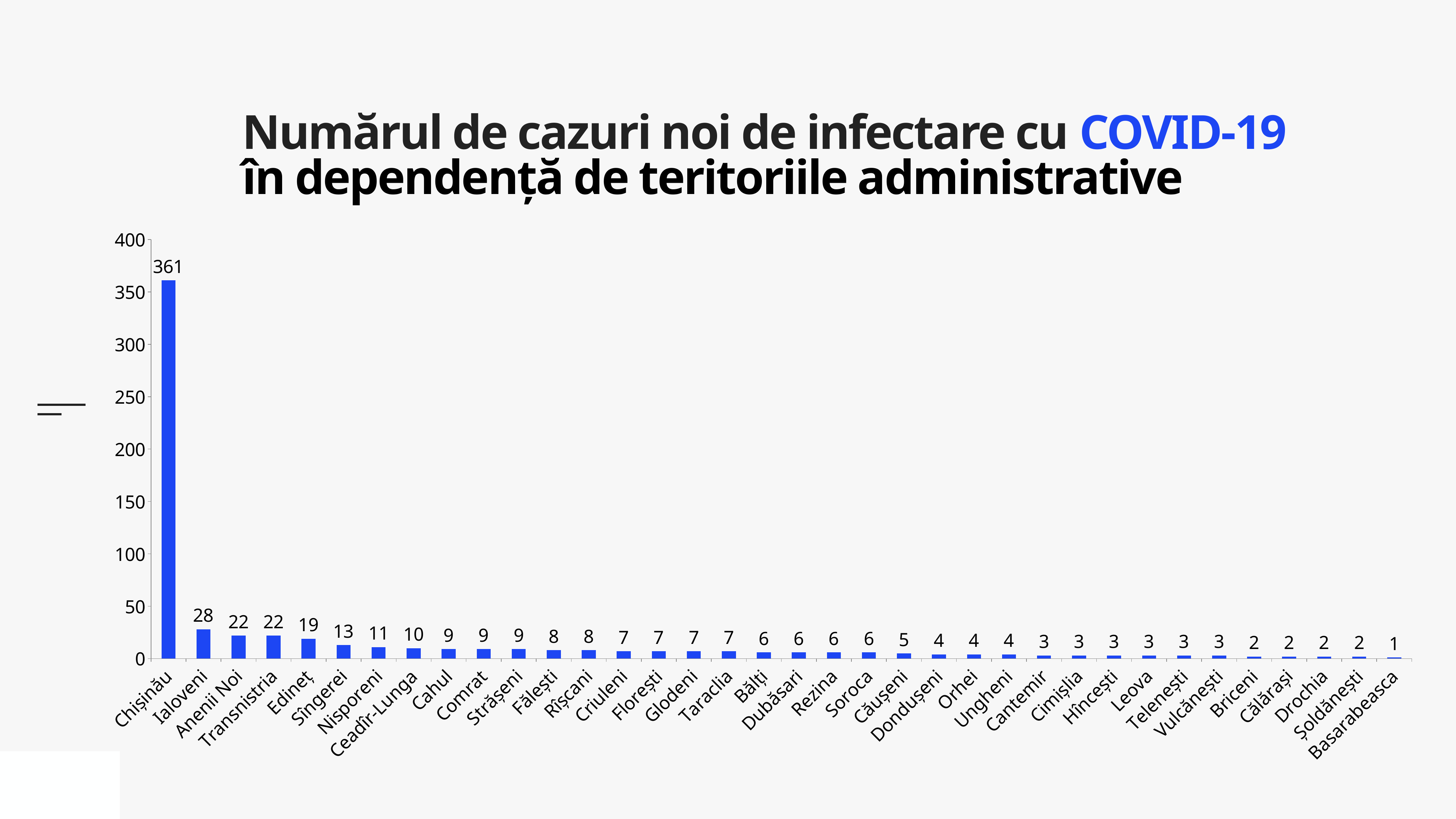
Which is larger, the value for Sîngerei or the value for Nisporeni? Sîngerei What kind of chart is shown on the slide? bar chart Which category has the lowest value? Basarabeasca What is the difference between the values for Chișinău and Ialoveni? 333 How many categories are shown on the x axis? 36 Which category has the highest value? Chișinău What is the value for Chișinău? 361 Do the values rise or fall from left to right along the x axis? fall What is the value for Ialoveni? 28 What is the value for Edineț? 19 Is the value for Chișinău greater or less than 350? greater What is the value for Cahul? 9